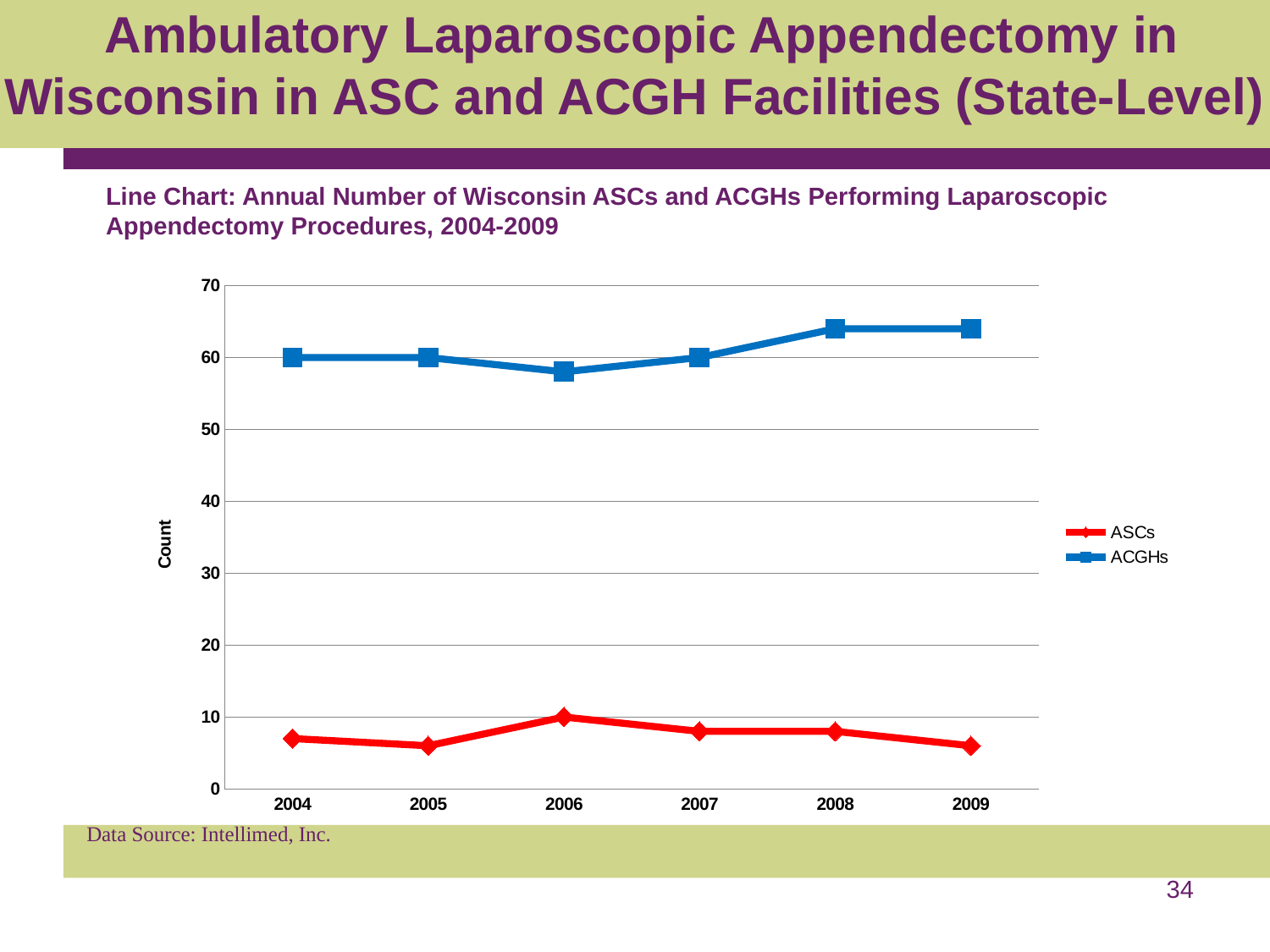
What is the label on the y axis? Count Is the value for ACGHs in 2006 greater or less than 60? less What is the value for ACGHs in 2004? 60 What is the value for ACGHs in 2007? 60 Which series has the larger value in 2008, ASCs or ACGHs? ACGHs Is the value for ASCs in 2009 greater or less than 10? less In which year is the ASCs value highest? 2006 How many years are plotted along the x axis? 6 What type of chart is shown on the slide? line chart Is the value for ACGHs in 2008 greater or less than 60? greater What is the value for ASCs in 2006? 10 How many series does the legend list? 2